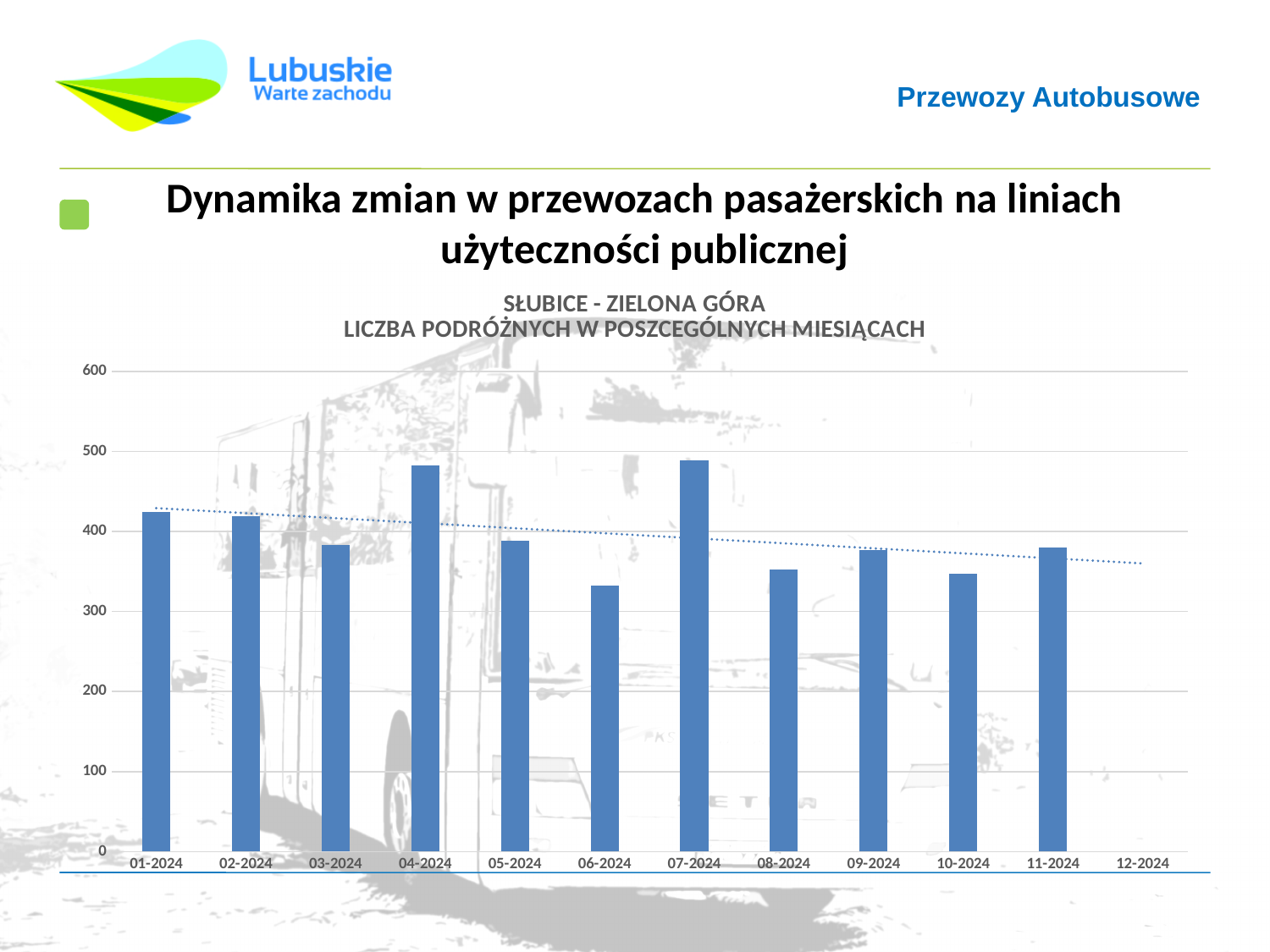
Which is larger, the value for 01-2024 or the value for 06-2024? 01-2024 Is the value for 04-2024 greater or less than 400? greater Which is larger, the value for 04-2024 or the value for 03-2024? 04-2024 Is the value for 01-2024 greater or less than 400? greater Which month has the lowest number of passengers? 06-2024 How many months have a bar plotted in the chart? 11 Is the value for 10-2024 greater or less than 400? less What is the title of the chart? SŁUBICE - ZIELONA GÓRA LICZBA PODRÓŻNYCH W POSZCEGÓLNYCH MIESIĄCACH Does the dotted trend line rise or fall from left to right? fall What kind of chart is shown on the slide? bar chart